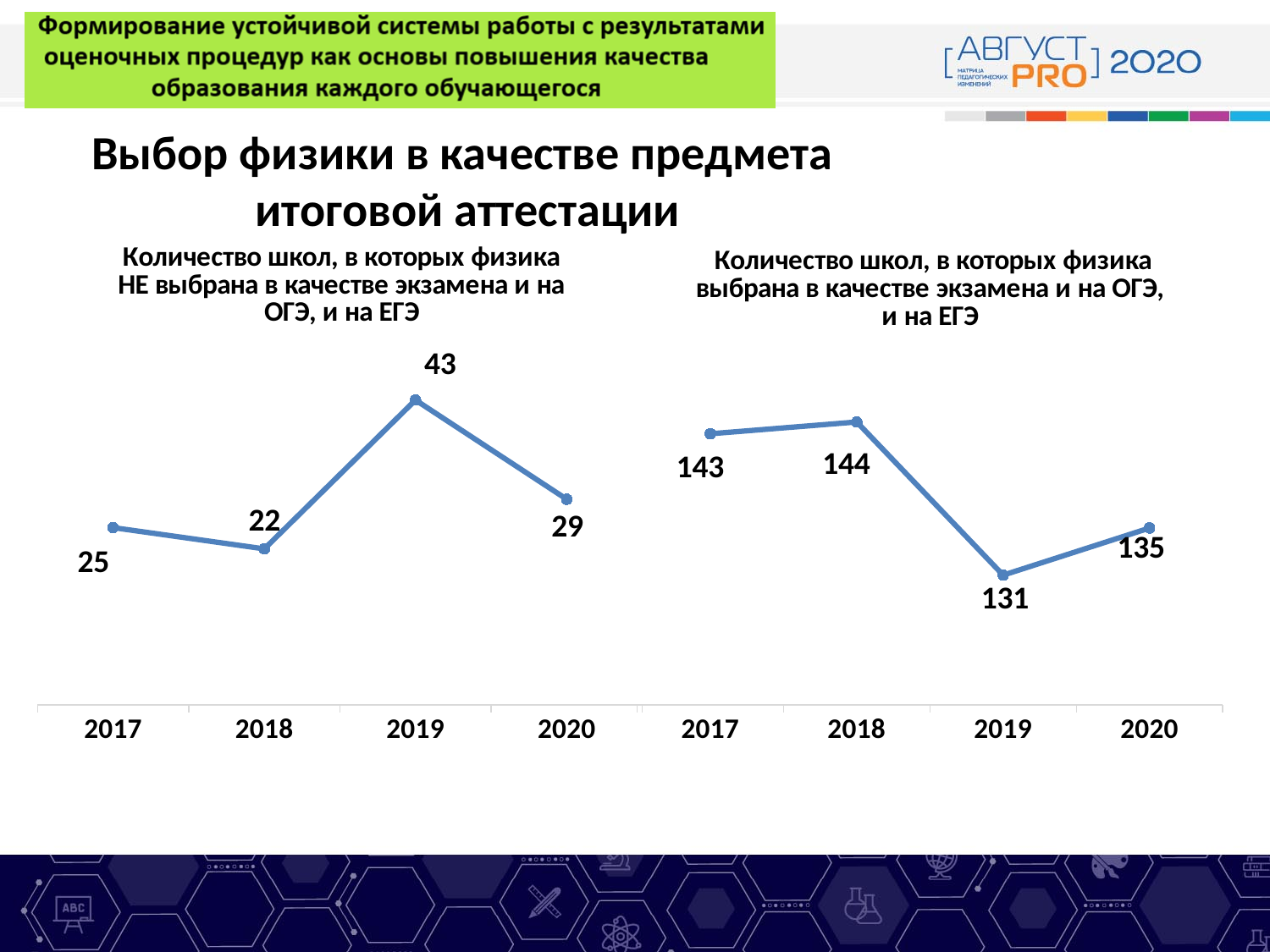
In the left chart (schools where physics is NOT chosen), what is the difference between the 2019 and 2020 values? 14 In the right chart (schools where physics is chosen), which year has the highest value? 2018 In the left chart (schools where physics is NOT chosen), what is the value for 2020? 29 In the right chart (schools where physics is chosen for both OGE and EGE), what is the value for 2017? 143 In the left chart (schools where physics is NOT chosen), which is larger: the value for 2017 or the value for 2020? 2020 In the right chart (schools where physics is chosen), what is the difference between the 2018 and 2019 values? 13 How many data points are plotted in the right chart (schools where physics is chosen)? 4 In the right chart (schools where physics is chosen), does the value rise or fall from 2019 to 2020? Rise In the left chart (schools where physics is NOT chosen), which year has the lowest value? 2018 In the right chart (schools where physics is chosen), which year has the lowest value? 2019 In the left chart (schools where physics is NOT chosen for both OGE and EGE), what is the value for 2019? 43 What type of chart is the left chart (schools where physics is NOT chosen)? Line chart